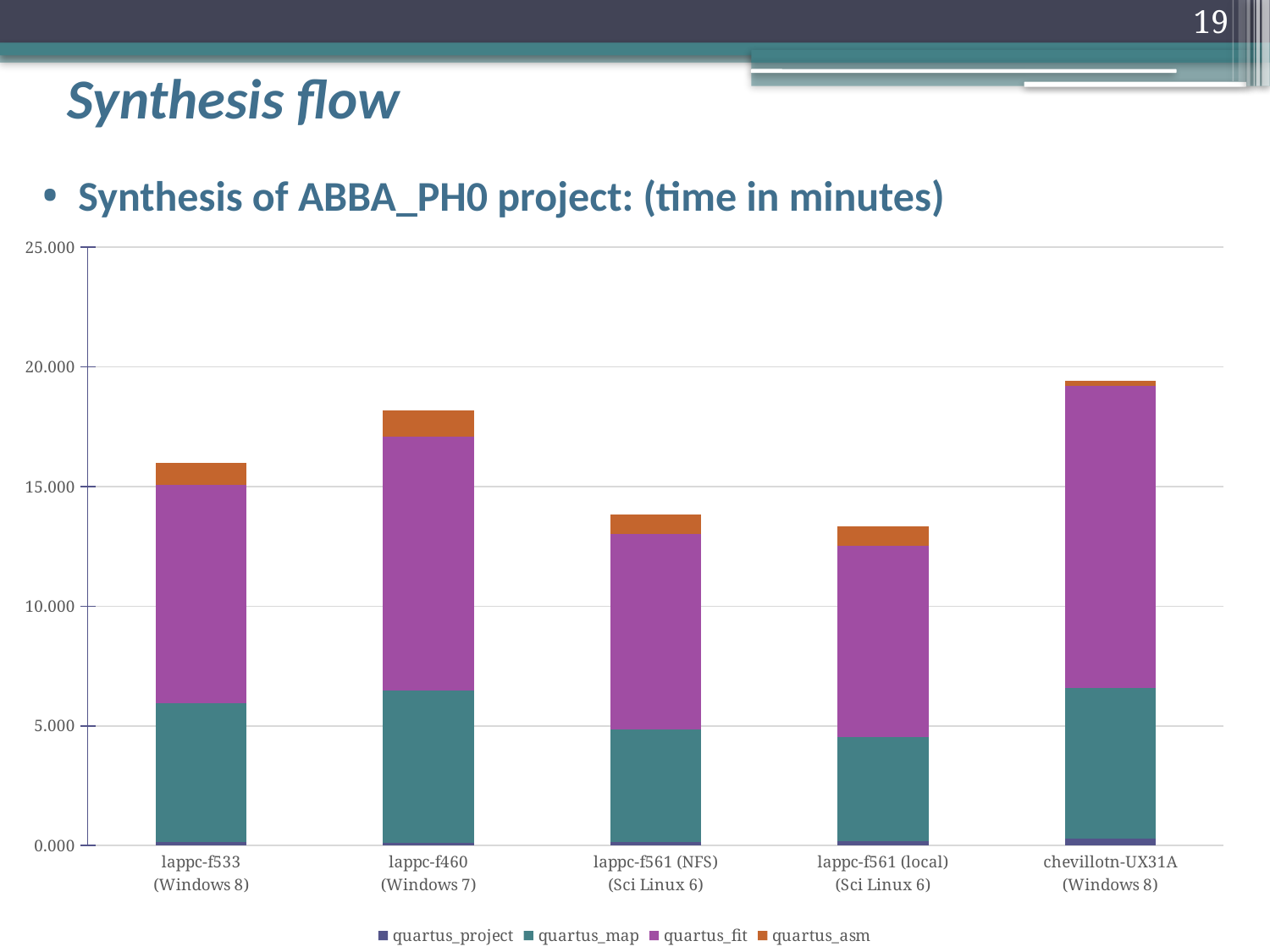
Which series is shown in purple in the chart legend? quartus_fit Which machine has the highest total synthesis time? chevillotn-UX31A (Windows 8) Is the total synthesis time for lappc-f561 (NFS) (Sci Linux 6) greater or less than 15.000? less How many series does the chart legend list? 4 Is the quartus_map time for lappc-f533 (Windows 8) greater or less than 10.000? less How many machines (categories) are shown on the x axis of the chart? 5 Is the total synthesis time for chevillotn-UX31A (Windows 8) greater or less than 20.000? less Which has the larger total synthesis time, chevillotn-UX31A (Windows 8) or lappc-f533 (Windows 8)? chevillotn-UX31A (Windows 8) Which series is listed last in the chart legend? quartus_asm Which has the larger total synthesis time, lappc-f460 (Windows 7) or lappc-f561 (NFS) (Sci Linux 6)? lappc-f460 (Windows 7) What kind of chart is shown on the slide? stacked bar chart